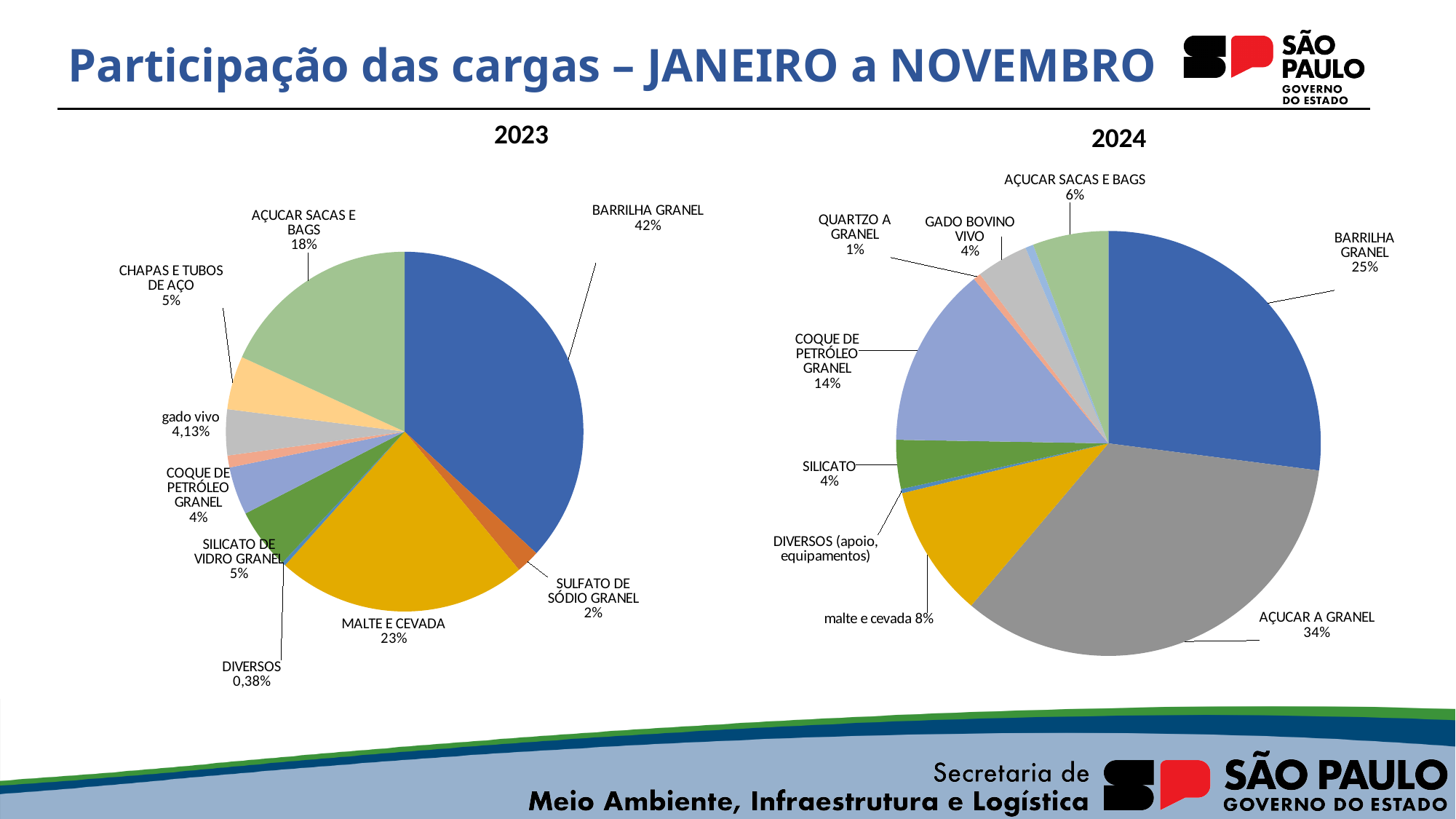
In the 2023 pie chart, which labelled category has the smallest share? DIVERSOS In the 2023 pie chart, what share does BARRILHA GRANEL have? 42% In the 2023 pie chart, which category has the largest share? BARRILHA GRANEL In the 2024 pie chart, what share does COQUE DE PETRÓLEO GRANEL have? 14% In the 2024 pie chart, which is larger: BARRILHA GRANEL or malte e cevada? BARRILHA GRANEL What type of chart is used for the 2023 and 2024 data on this slide? Pie chart In the 2023 pie chart, what share is shown for gado vivo? 4,13% In the 2024 pie chart, what is the difference between the shares of AÇUCAR A GRANEL and BARRILHA GRANEL? 9 percentage points In the 2023 pie chart, what is the difference between the shares of BARRILHA GRANEL and AÇUCAR SACAS E BAGS? 24 percentage points In the 2024 pie chart, which category has the largest share? AÇUCAR A GRANEL In the 2024 pie chart, what share does AÇUCAR A GRANEL have? 34% In the 2023 pie chart, what share does MALTE E CEVADA have? 23%